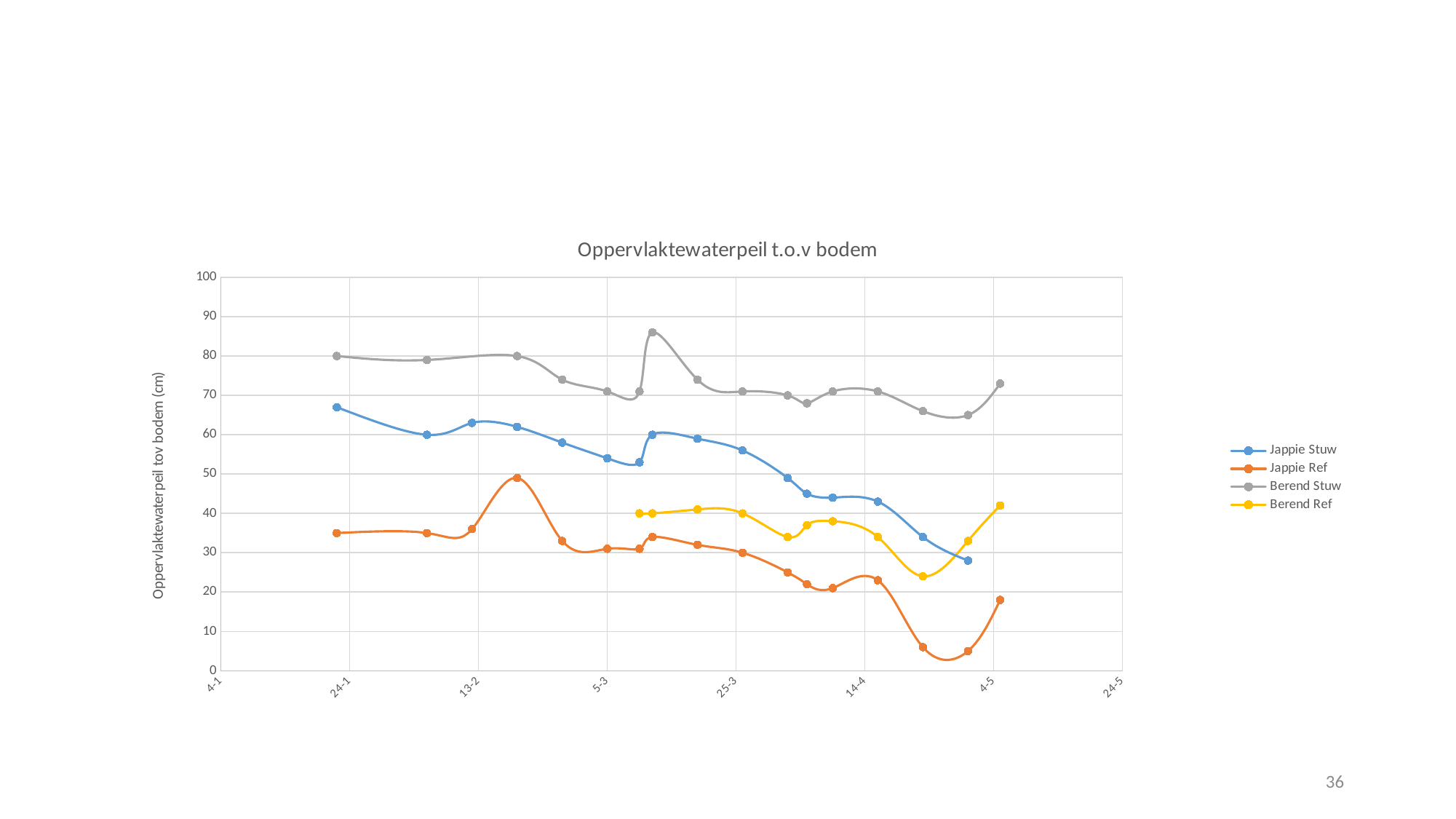
Around 25-3, which is larger: Jappie Stuw or Berend Ref? Jappie Stuw Which series has the lowest values across the chart? Jappie Ref Is the lowest value for Jappie Ref greater or less than 10? less Do the values for Jappie Stuw generally rise or fall along the x axis? fall Which series starts latest on the x axis? Berend Ref What is the title of the chart? Oppervlaktewaterpeil t.o.v bodem Which colour is used for the Berend Ref series? yellow What kind of chart is shown on the slide? line chart Which series has the highest values across the chart? Berend Stuw Is the highest value for Berend Stuw greater or less than 80? greater Is the first value for Jappie Stuw greater or less than 60? greater How many series does the legend list? 4